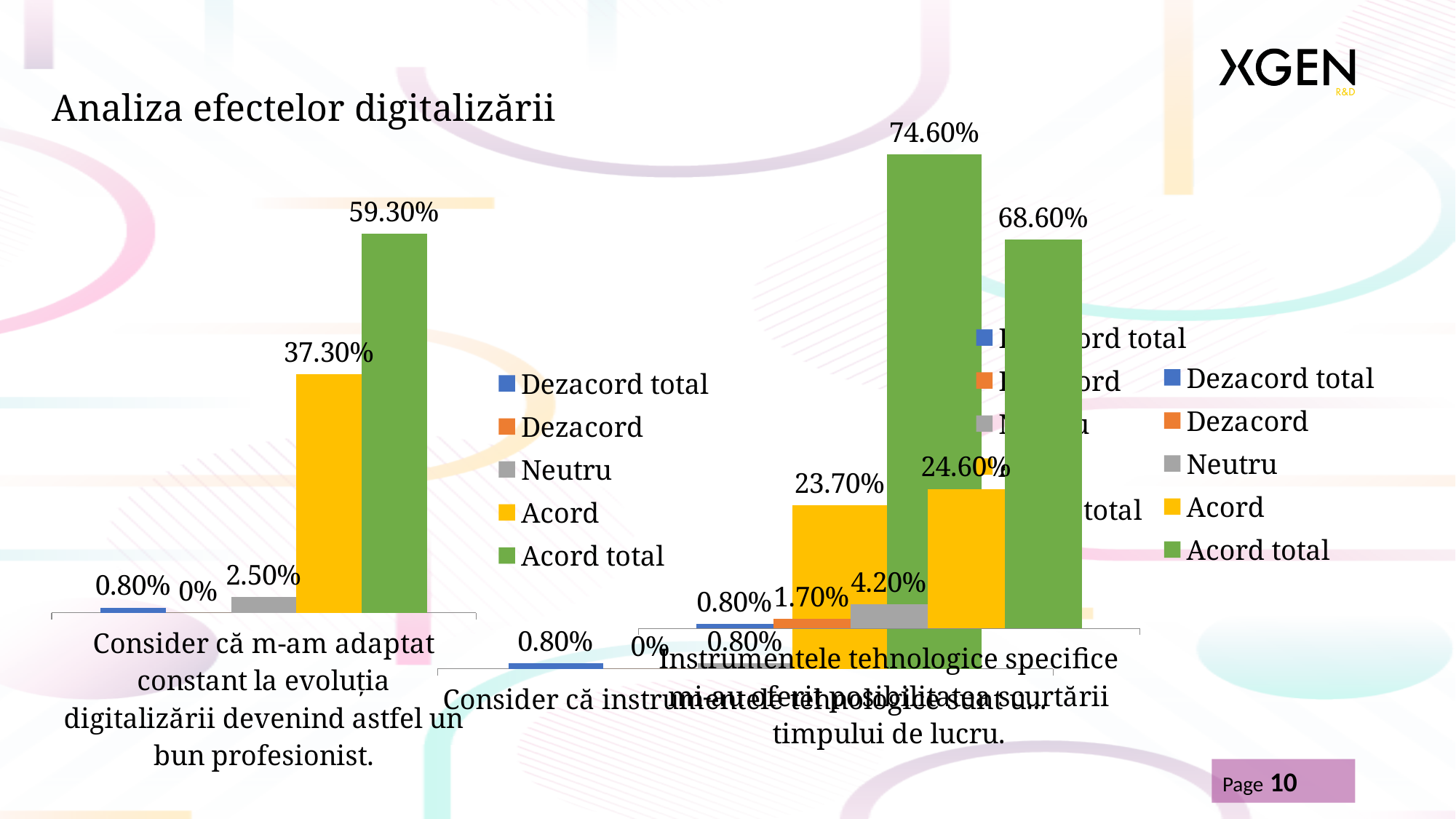
In the chart titled 'Consider că m-am adaptat constant la evoluția digitalizării devenind astfel un bun profesionist.', what is the value for Acord? 37.30% In the chart titled 'Consider că m-am adaptat constant la evoluția digitalizării devenind astfel un bun profesionist.', what is the difference between Acord total and Acord? 22.00% In the chart titled 'Consider că m-am adaptat constant la evoluția digitalizării devenind astfel un bun profesionist.', which series has the lowest value? Dezacord In the chart titled 'Instrumentele tehnologice specifice mi-au oferit posibilitatea scurtării timpului de lucru.', what is the value for Acord total? 68.60% In the chart titled 'Instrumentele tehnologice specifice mi-au oferit posibilitatea scurtării timpului de lucru.', which is larger, Dezacord or Neutru? Neutru How many series does the legend of the chart titled 'Consider că m-am adaptat constant la evoluția digitalizării devenind astfel un bun profesionist.' list? 5 In the chart titled 'Instrumentele tehnologice specifice mi-au oferit posibilitatea scurtării timpului de lucru.', what is the value for Neutru? 4.20% In the chart titled 'Instrumentele tehnologice specifice mi-au oferit posibilitatea scurtării timpului de lucru.', what colour is the Acord total bar? Green In the chart titled 'Consider că m-am adaptat constant la evoluția digitalizării devenind astfel un bun profesionist.', what is the value for Acord total? 59.30% In the chart titled 'Consider că m-am adaptat constant la evoluția digitalizării devenind astfel un bun profesionist.', which series has the highest value? Acord total In the chart titled 'Consider că m-am adaptat constant la evoluția digitalizării devenind astfel un bun profesionist.', what is the value for Neutru? 2.50% What kind of chart is the chart titled 'Consider că m-am adaptat constant la evoluția digitalizării devenind astfel un bun profesionist.'? Bar chart